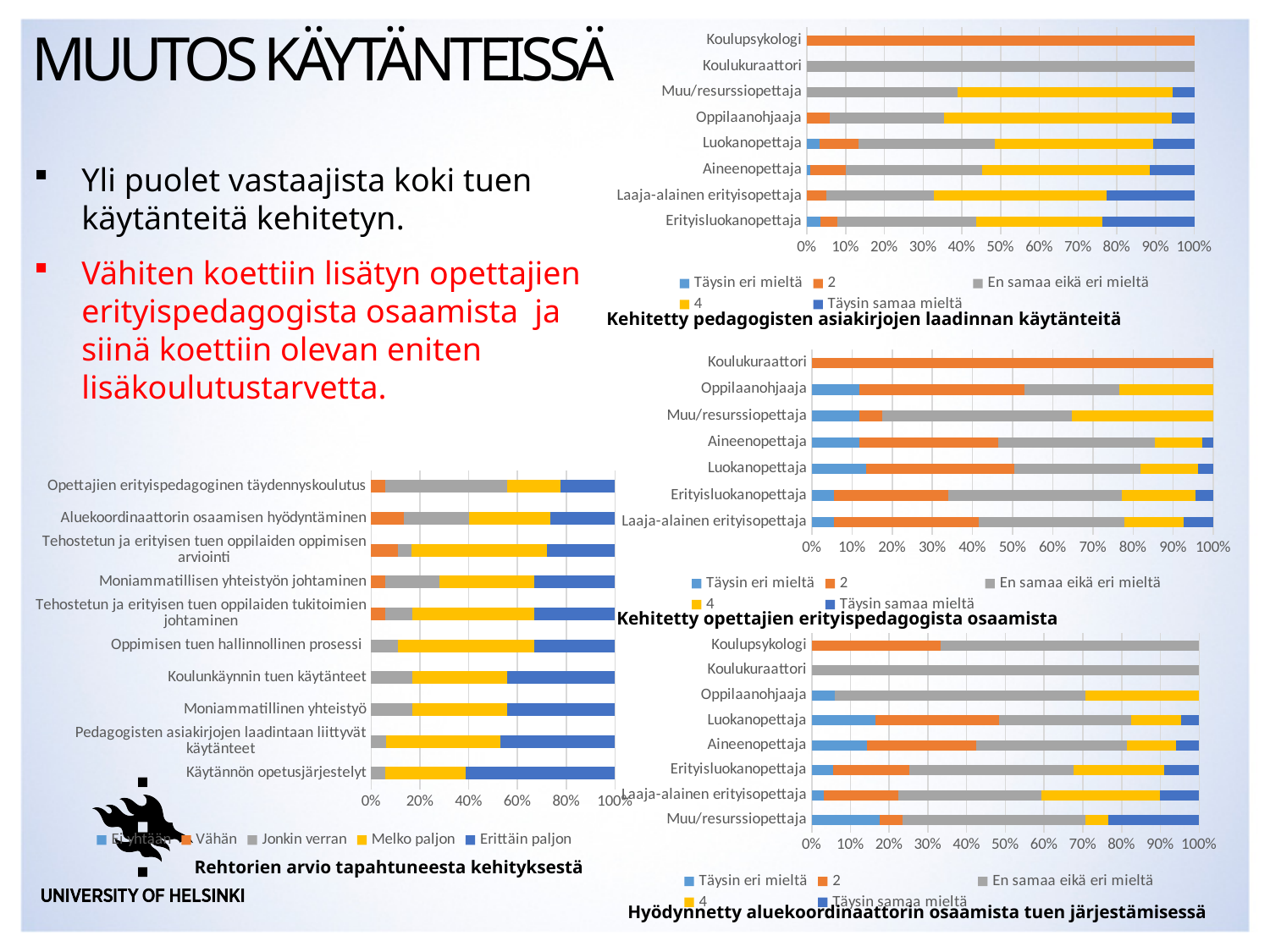
How many series does the legend of the 'Rehtorien arvio tapahtuneesta kehityksestä' chart list? 5 How many categories are plotted in the 'Kehitetty pedagogisten asiakirjojen laadinnan käytänteitä' chart? 8 How many series does the legend of the 'Kehitetty pedagogisten asiakirjojen laadinnan käytänteitä' chart list? 5 In the 'Hyödynnetty aluekoordinaattorin osaamista tuen järjestämisessä' chart, is the 'En samaa eikä eri mieltä' value for 'Koulukuraattori' greater or less than 90%? greater What is the title of the chart at the bottom right of the slide? Hyödynnetty aluekoordinaattorin osaamista tuen järjestämisessä In the 'Rehtorien arvio tapahtuneesta kehityksestä' chart, is the 'Erittäin paljon' value for 'Käytännön opetusjärjestelyt' greater or less than 40%? greater In the 'Kehitetty opettajien erityispedagogista osaamista' chart, is the '2' value for 'Koulukuraattori' greater or less than 90%? greater How many categories are plotted in the 'Kehitetty opettajien erityispedagogista osaamista' chart? 7 What kind of chart is 'Rehtorien arvio tapahtuneesta kehityksestä'? Stacked bar chart In the 'Rehtorien arvio tapahtuneesta kehityksestä' chart, which has the larger 'Erittäin paljon' share: 'Käytännön opetusjärjestelyt' or 'Opettajien erityispedagoginen täydennyskoulutus'? Käytännön opetusjärjestelyt How many charts are shown on the slide? 4